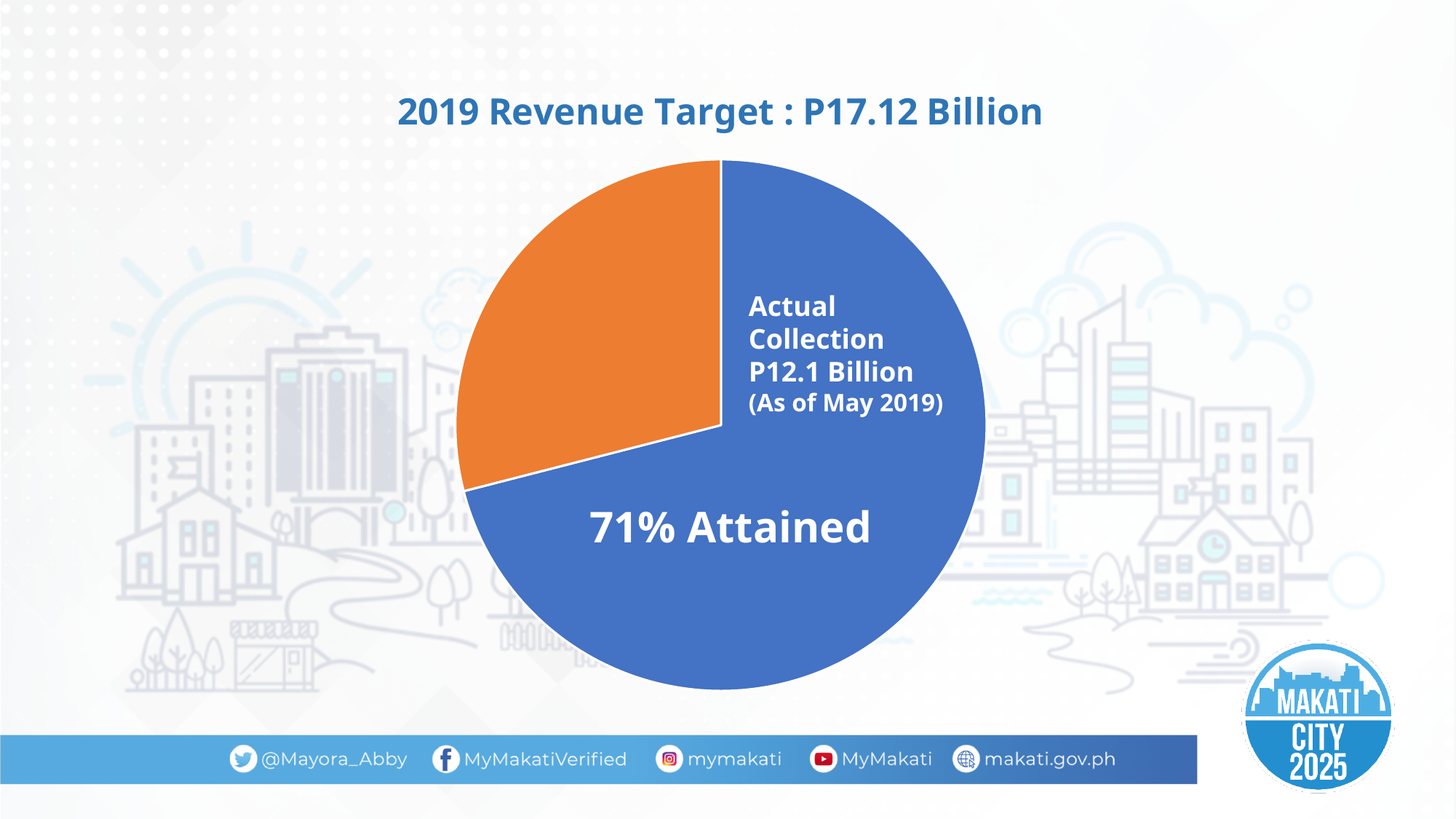
How many slices does the pie chart have? 2 Which slice of the pie chart is larger, the blue slice or the orange slice? the blue slice What is the actual collection value shown on the pie chart? P12.1 Billion Is the share of the target attained greater or less than 50%? greater What percentage of the revenue target has been attained according to the pie chart? 71% As of what date is the actual collection figure reported? May 2019 What kind of chart is shown on the slide? pie chart Which slice of the pie chart is the largest? Actual Collection What is the title of the chart? 2019 Revenue Target : P17.12 Billion What is the difference between the 2019 revenue target and the actual collection? P5.02 Billion What share of the pie does the orange slice represent? 29%